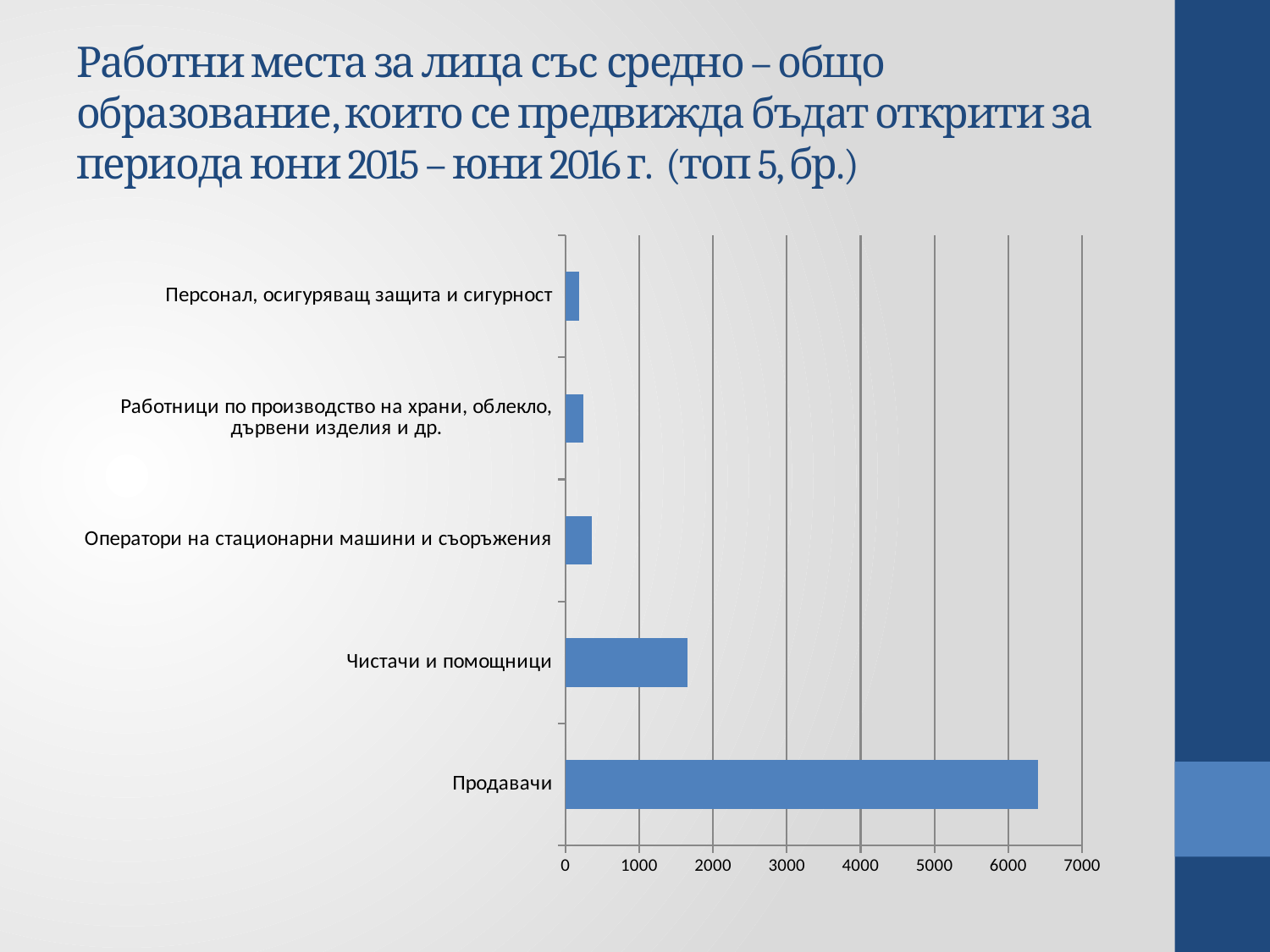
How many categories (occupations) are shown in the chart? 5 Which is larger: the value for Чистачи и помощници or the value for Оператори на стационарни машини и съоръжения? Чистачи и помощници Is the value for Чистачи и помощници greater or less than 2000? less Is the value for Продавачи greater or less than 6000? greater Is the value for Персонал, осигуряващ защита и сигурност greater or less than 1000? less What kind of chart is shown on the slide? bar chart Which category has the highest value in the chart? Продавачи Which is larger: the value for Продавачи or the value for Чистачи и помощници? Продавачи What is the highest value shown on the horizontal axis of the chart? 7000